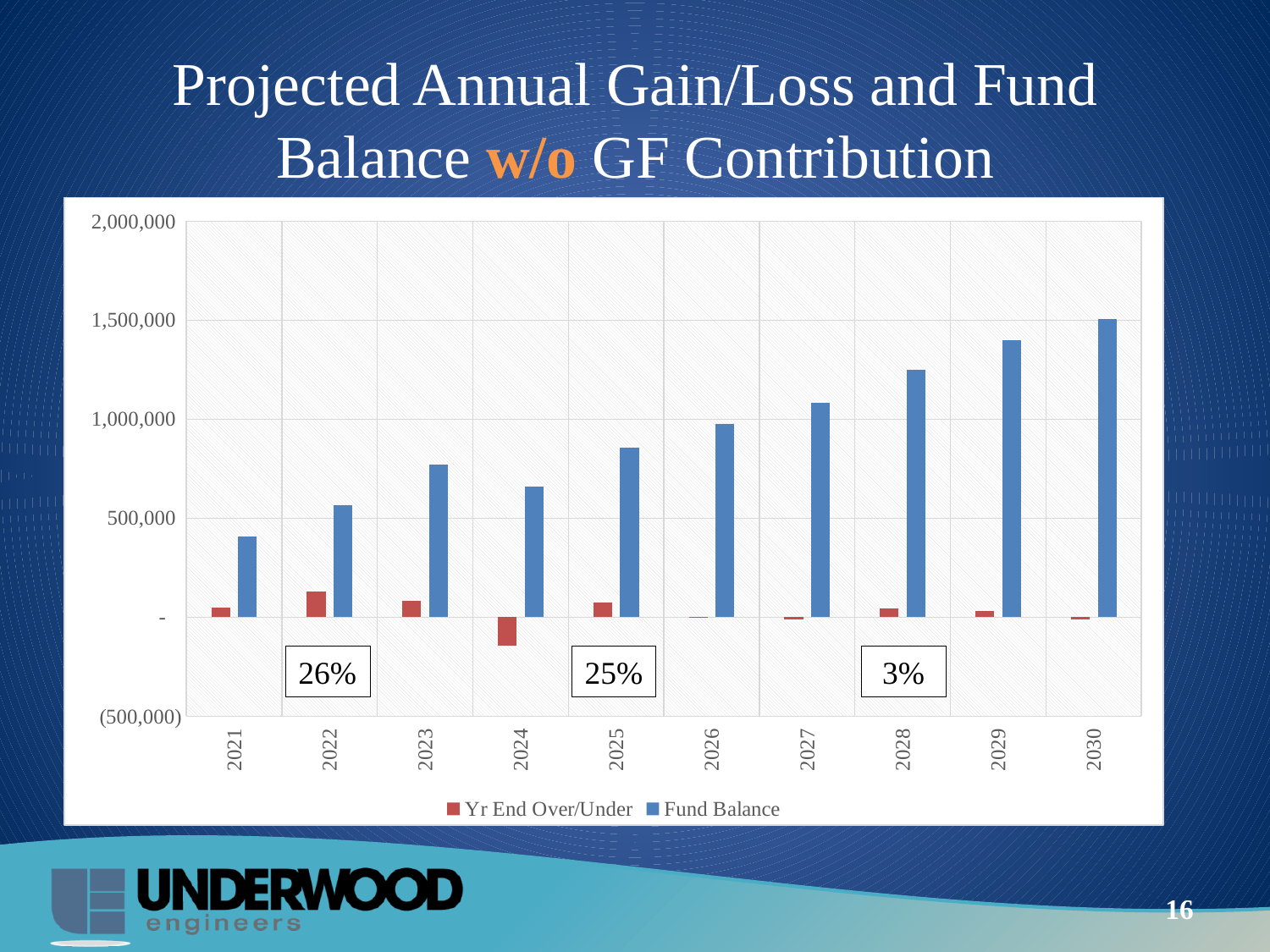
Which is larger, the Fund Balance for 2023 or for 2024? 2023 Is the Fund Balance for 2028 greater or less than 1,000,000? greater How many series does the legend list? 2 Is the Fund Balance for 2029 greater or less than 1,500,000? less Which year has the highest Fund Balance? 2030 Is the Fund Balance for 2021 greater or less than 500,000? less Which year has the lowest Fund Balance? 2021 Which year has the lowest Yr End Over/Under value? 2024 How many years are shown on the x axis? 10 What kind of chart is shown on the slide? bar chart Which year has the highest Yr End Over/Under value? 2022 What are the two series named in the legend? Yr End Over/Under and Fund Balance